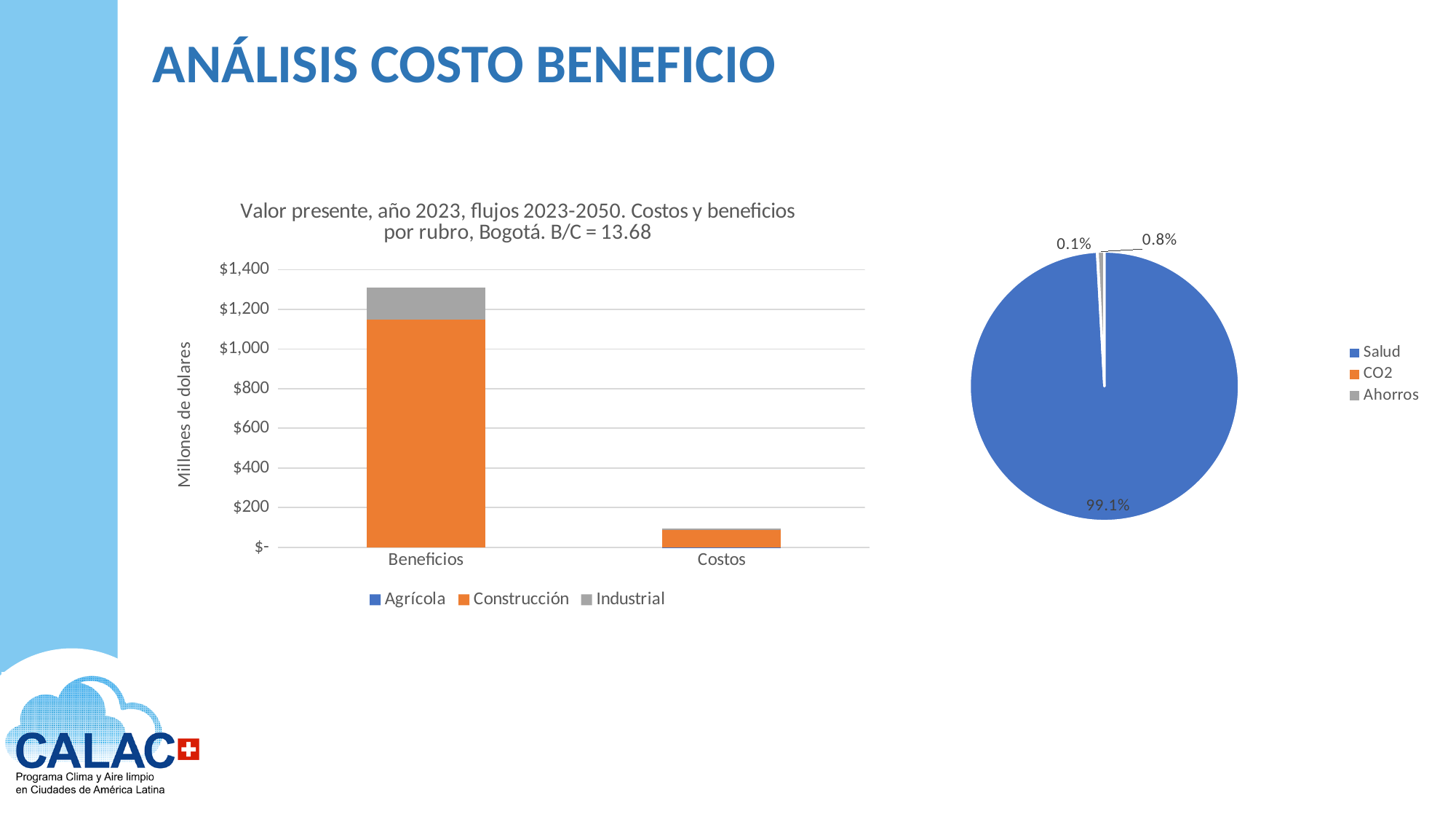
In the pie chart on the right, which category has the largest slice? Salud In the bar chart on the left, is the total value for Beneficios greater or less than $1,200? greater In the pie chart on the right, what share does Ahorros represent? 0.8% What is the y-axis label of the bar chart on the left? Millones de dolares How many series does the legend of the bar chart on the left list? 3 In the bar chart on the left, which bar is taller, Beneficios or Costos? Beneficios In the pie chart on the right, which category has the smallest slice? CO2 What kind of chart is the chart on the left titled 'Valor presente, año 2023, flujos 2023-2050'? Stacked bar chart How many entries does the legend of the pie chart on the right list? 3 In the pie chart on the right, what share does Salud represent? 99.1% In the bar chart on the left, is the value for Costos greater or less than $200? less How many categories are shown on the x axis of the bar chart on the left? 2